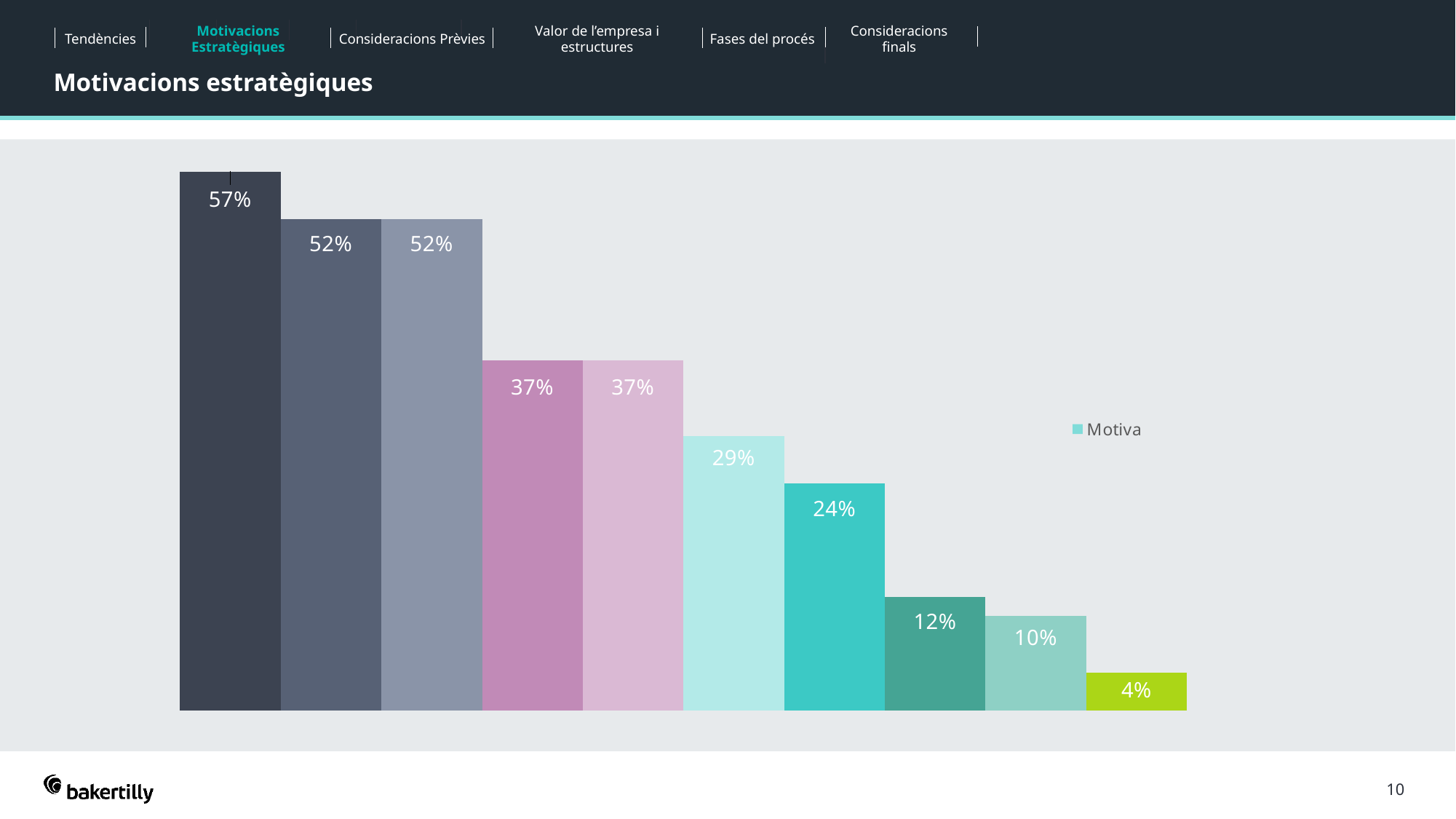
What kind of chart is shown on the slide? bar chart How many series does the legend list? 1 What is the value of the first (leftmost) bar? 57% What is the value of the last (rightmost, green) bar? 4% What is the difference between the first bar (57%) and the second bar (52%)? 5% What is the value shown on the tallest bar? 57% What is the difference between the sixth bar (29%) and the seventh bar (24%)? 5% How many bars are plotted in the chart? 10 What is the value of the seventh bar from the left (the bright teal one)? 24% What is the value shown on the shortest bar? 4% What is the legend entry shown on the chart? Motiva Do the bar values rise or fall from left to right? fall